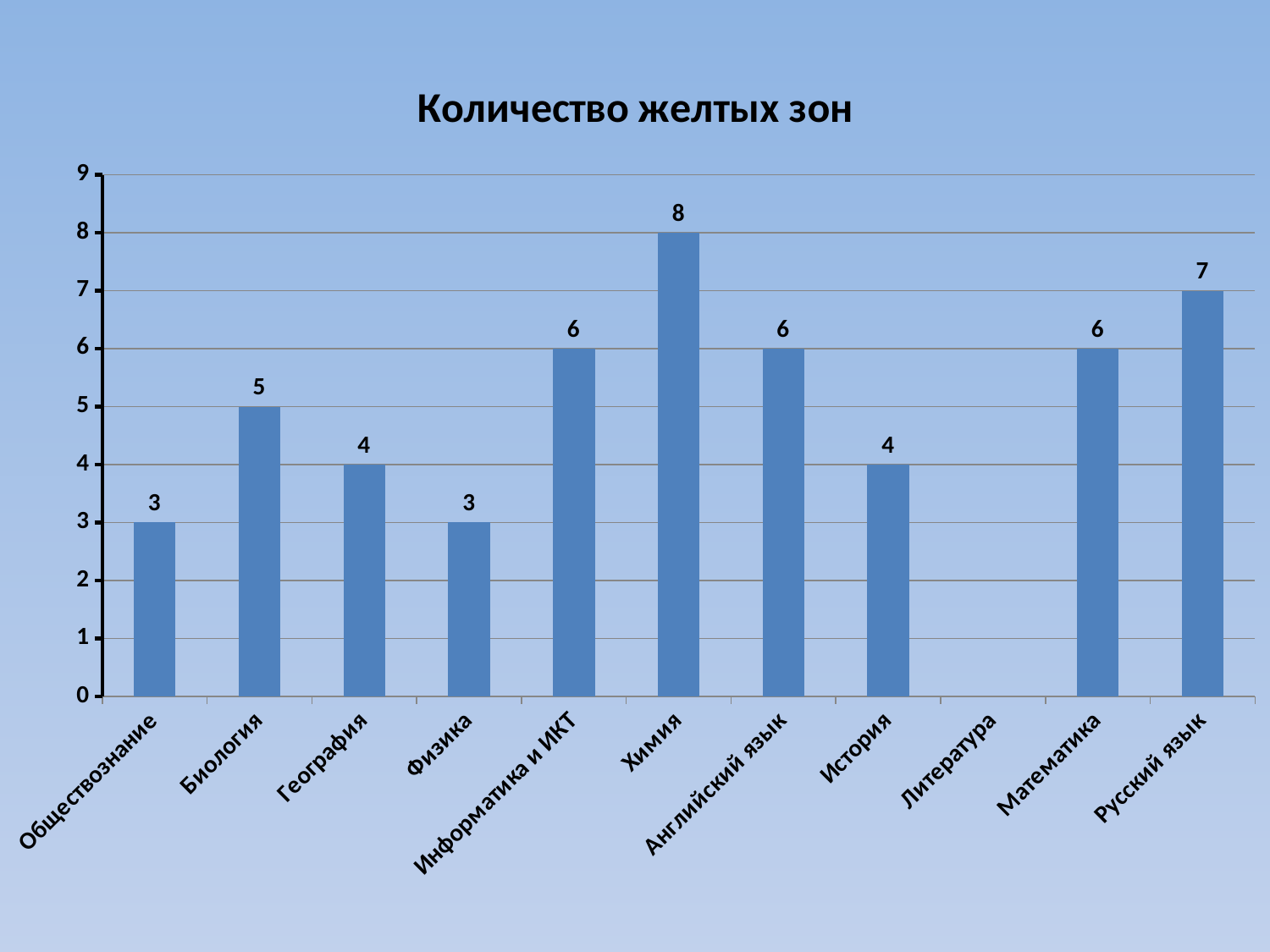
Which category has the highest value? Химия Which is larger, the value for Информатика и ИКТ or the value for Физика? Информатика и ИКТ What is the value for Биология? 5 How many categories are shown on the x axis? 11 What is the difference between the values for Русский язык and Математика? 1 What is the value for История? 4 What kind of chart is this? Bar chart What is the value for Химия? 8 What is the title of the chart? Количество желтых зон Which is larger, the value for Биология or the value for География? Биология What is the value for Русский язык? 7 What is the difference between the values for Химия and Обществознание? 5